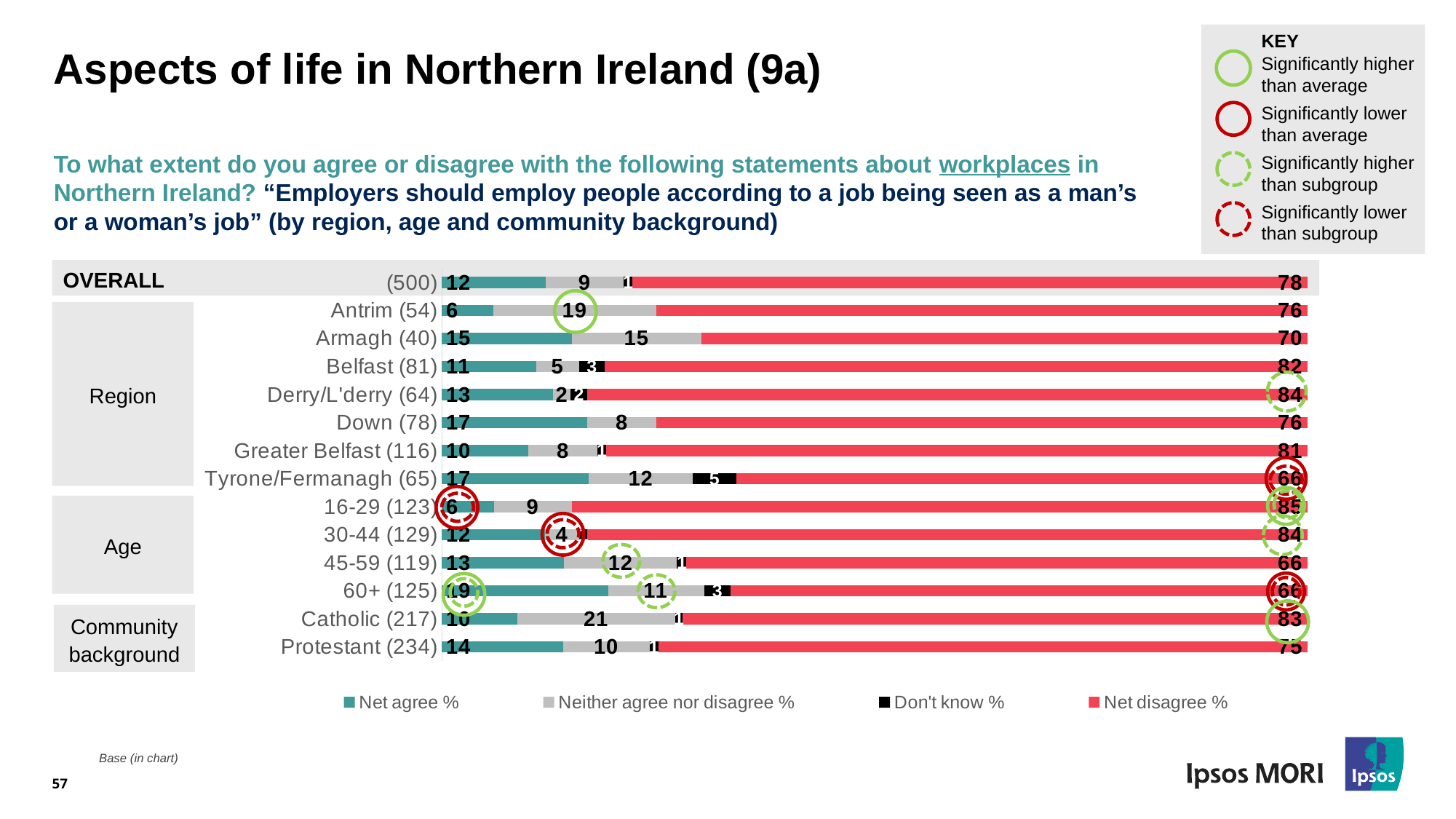
What colour represents Net disagree % in the chart? Red What kind of chart is shown on the slide? Stacked bar chart Which has a larger Net disagree %, Belfast (81) or Down (78)? Belfast (81) How many categories (rows) are plotted in the chart, including OVERALL? 14 What is the Net disagree % for Belfast (81)? 82 Which category has the highest Net agree %? 60+ (125) What is the Net disagree % for the OVERALL (500) row? 78 What is the Neither agree nor disagree % for Catholic (217)? 21 What is the difference in Net disagree % between Armagh (40) and Tyrone/Fermanagh (65)? 4 Which category has the highest Neither agree nor disagree %? Catholic (217) What is the Net agree % for Down (78)? 17 How many series does the legend list? 4